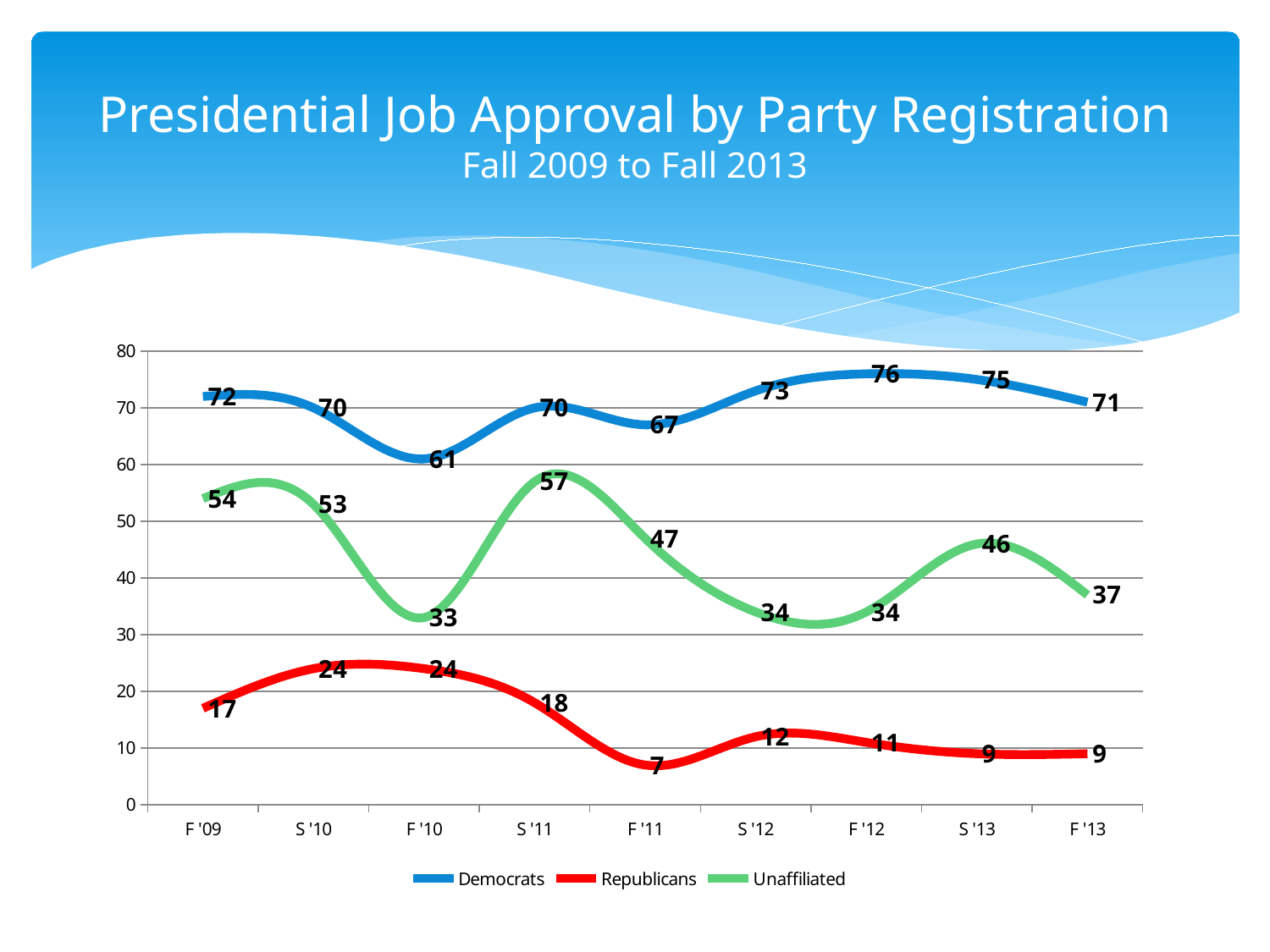
What is the Democrats' approval value at F '10? 61 How many time points are plotted along the x axis? 9 Which series has the higher value at S '12, Unaffiliated or Republicans? Unaffiliated What is the difference between the Democrats' and Republicans' values at F '13? 62 What is the Republicans' approval value at F '11? 7 What is the Unaffiliated approval value at S '11? 57 What is the title of the chart on the slide? Presidential Job Approval by Party Registration How many series does the legend list? 3 At which time point is the Democrats' approval highest? F '12 What kind of chart is shown on the slide? Line chart Does the Republicans' approval rise or fall from F '10 to F '11? Fall At which time point is the Republicans' approval lowest? F '11